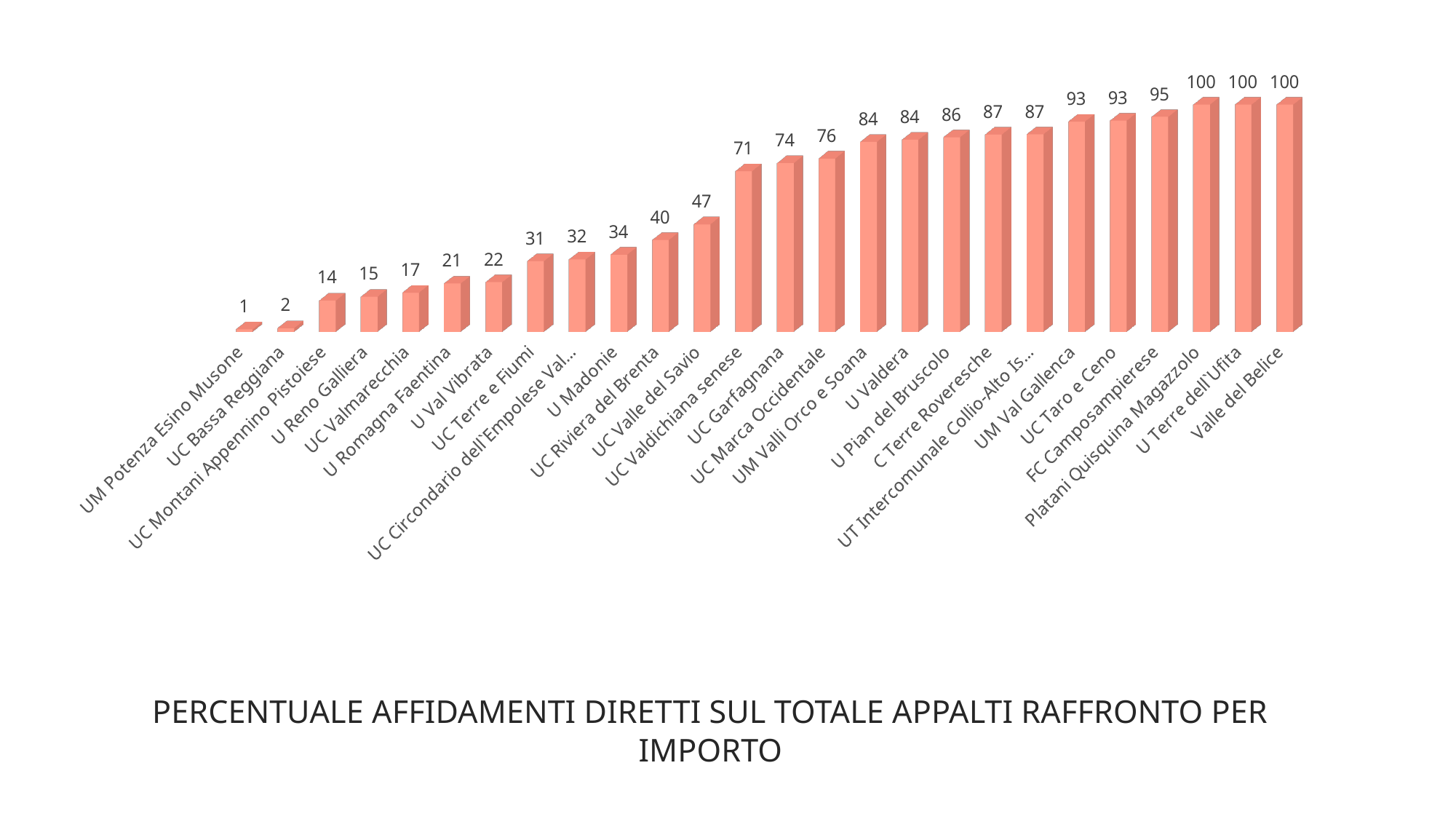
What kind of chart is shown on the slide? Bar chart How many categories are shown on the chart? 26 What is the value for UC Garfagnana? 74 Do the values rise or fall from left to right along the x axis? Rise What is the value for FC Camposampierese? 95 What is the highest value shown on the chart? 100 What is the difference between the values for UC Valdichiana senese and UC Valle del Savio? 24 Which category has the lowest value? UM Potenza Esino Musone What is the value for UC Valle del Savio? 47 What is the difference between the values for U Pian del Bruscolo and U Madonie? 52 Which is larger, the value for UC Riviera del Brenta or the value for UC Marca Occidentale? UC Marca Occidentale What is the value for U Val Vibrata? 22